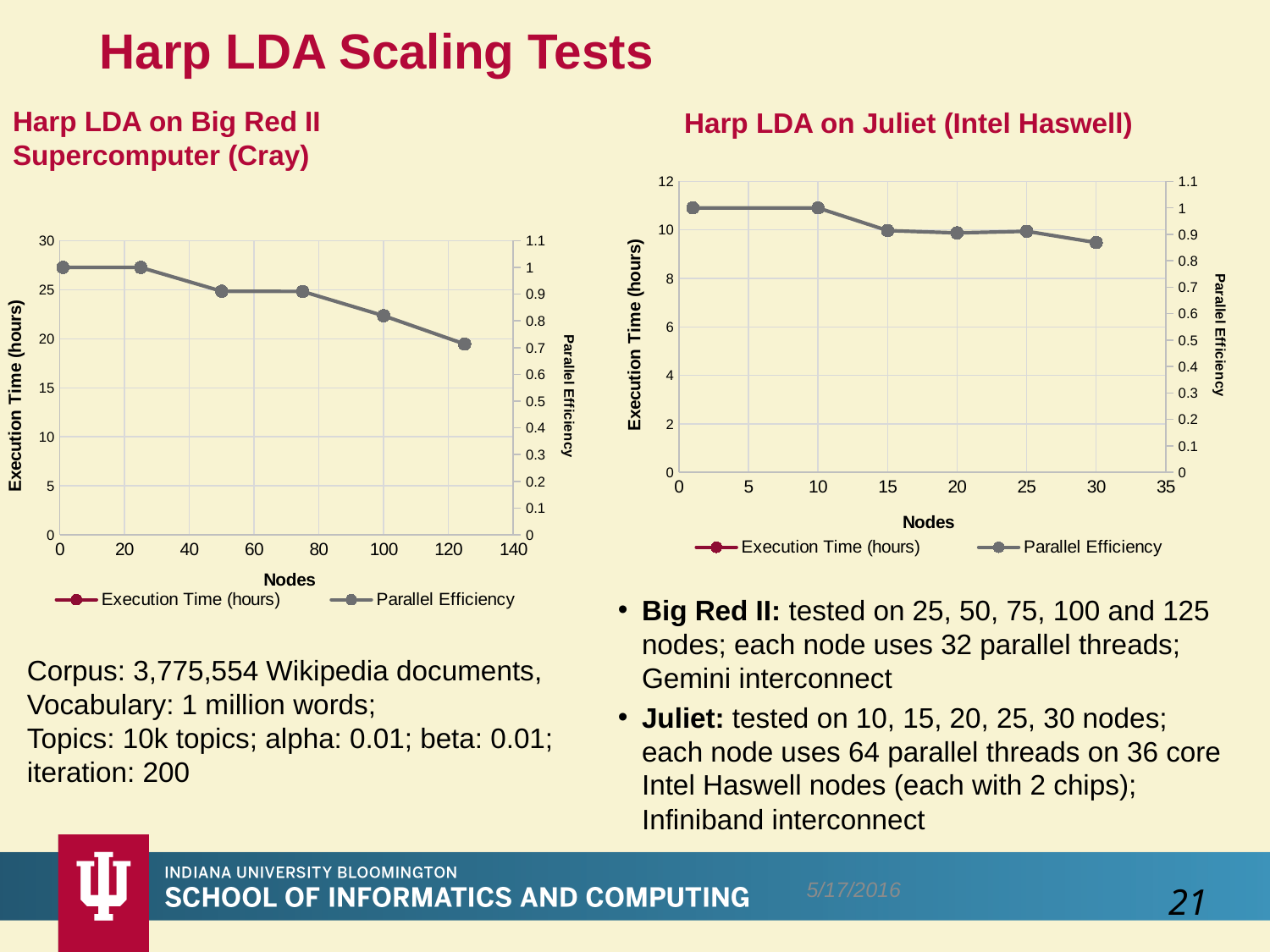
How many data points are plotted on the Parallel Efficiency line in the 'Harp LDA on Juliet (Intel Haswell)' chart? 6 What is the label of the left y axis in the 'Harp LDA on Big Red II Supercomputer (Cray)' chart? Execution Time (hours) In the 'Harp LDA on Juliet (Intel Haswell)' chart, is the Parallel Efficiency at 30 nodes greater or less than 0.8? greater How many series does the legend of the 'Harp LDA on Juliet (Intel Haswell)' chart list? 2 What is the label of the x axis in the 'Harp LDA on Juliet (Intel Haswell)' chart? Nodes In the 'Harp LDA on Big Red II Supercomputer (Cray)' chart, is Parallel Efficiency higher at 25 nodes or at 125 nodes? 25 nodes In the 'Harp LDA on Big Red II Supercomputer (Cray)' chart, is the Parallel Efficiency at 125 nodes greater or less than 0.8? less In the 'Harp LDA on Big Red II Supercomputer (Cray)' chart, at which number of nodes is Parallel Efficiency lowest? 125 In the 'Harp LDA on Big Red II Supercomputer (Cray)' chart, does Parallel Efficiency rise or fall as the number of nodes increases? Fall In the 'Harp LDA on Juliet (Intel Haswell)' chart, does Parallel Efficiency rise or fall as the number of nodes increases? Fall What kind of chart is the 'Harp LDA on Big Red II Supercomputer (Cray)' chart? Line chart In the 'Harp LDA on Big Red II Supercomputer (Cray)' chart, is the Parallel Efficiency at 50 nodes greater or less than 0.8? greater